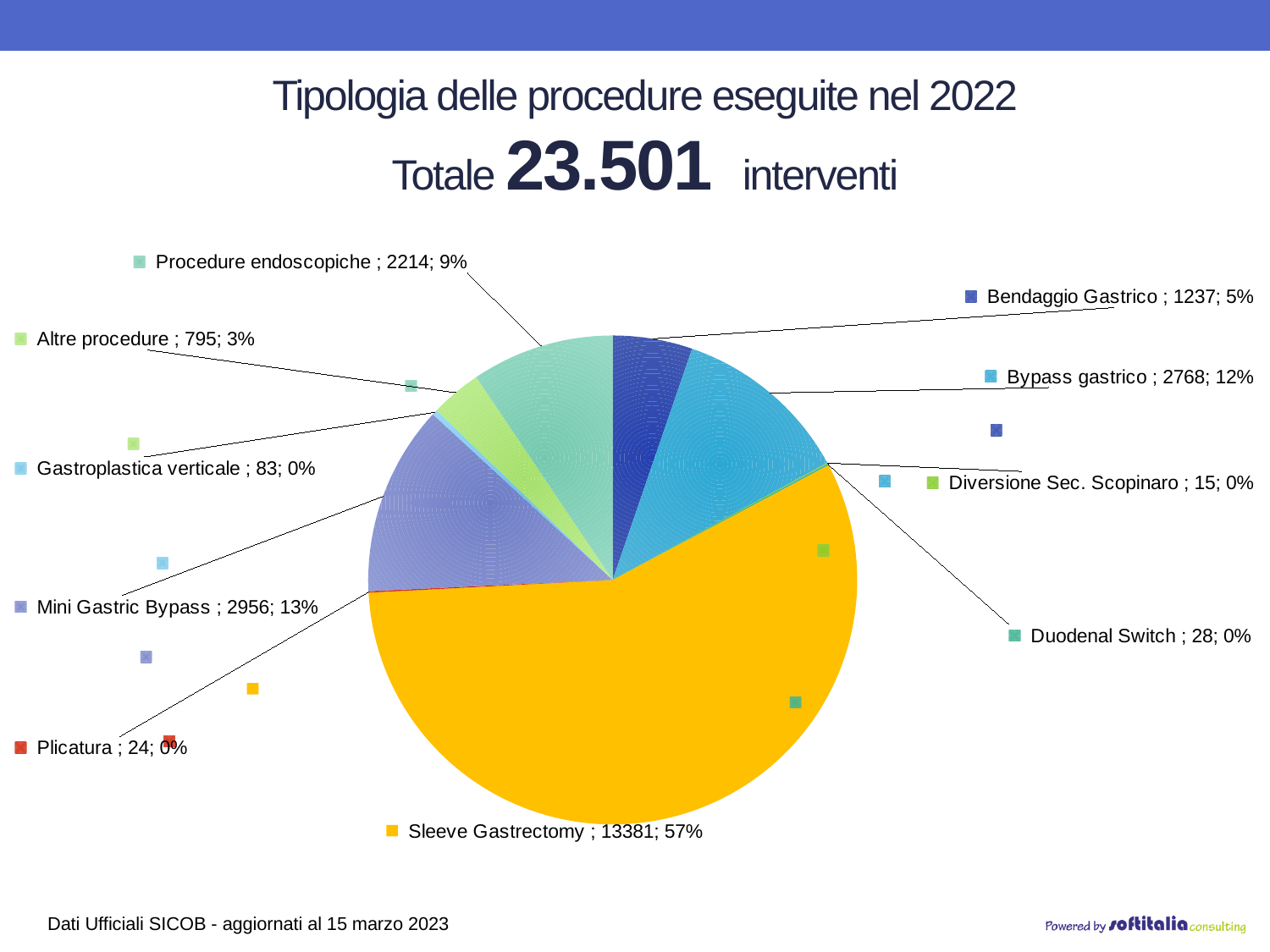
What total number of interventions is stated in the slide title? 23.501 What percentage share does the Mini Gastric Bypass slice have? 13% Which procedure has the smallest number of interventions? Diversione Sec. Scopinaro How many procedure categories are shown in the pie chart? 10 Which has more interventions, Procedure endoscopiche or Bendaggio Gastrico? Procedure endoscopiche How many interventions are labelled for Sleeve Gastrectomy? 13381 Which procedure has the largest slice of the pie? Sleeve Gastrectomy What percentage share does the Procedure endoscopiche slice have? 9% What kind of chart is shown on the slide? pie chart How many interventions are labelled for Bypass gastrico? 2768 How many interventions are labelled for Plicatura? 24 What is the difference in interventions between Mini Gastric Bypass and Bypass gastrico? 188